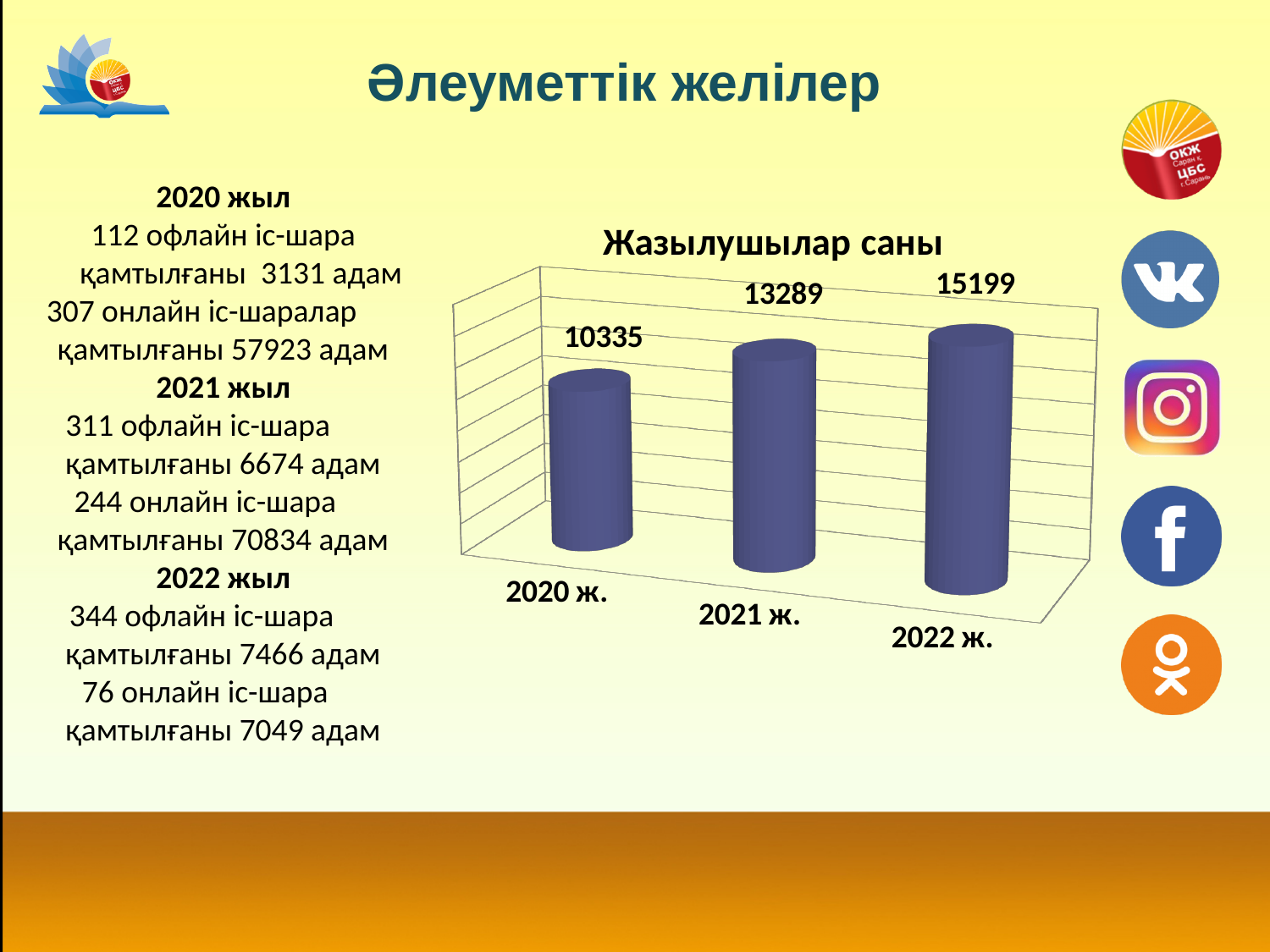
What kind of chart is shown on the slide? bar chart How many categories are shown in the chart? 3 Which year has the lowest value in the chart? 2020 ж. What is the value for 2021 ж. in the chart? 13289 What is the value for 2020 ж. in the chart? 10335 What is the difference between the values for 2022 ж. and 2020 ж.? 4864 What is the value for 2022 ж. in the chart? 15199 What is the difference between the values for 2021 ж. and 2020 ж.? 2954 Which is larger, the value for 2021 ж. or the value for 2022 ж.? 2022 ж. Which year has the highest value in the chart? 2022 ж. What is the title of the chart? Жазылушылар саны Do the values rise or fall from 2020 ж. to 2022 ж.? rise